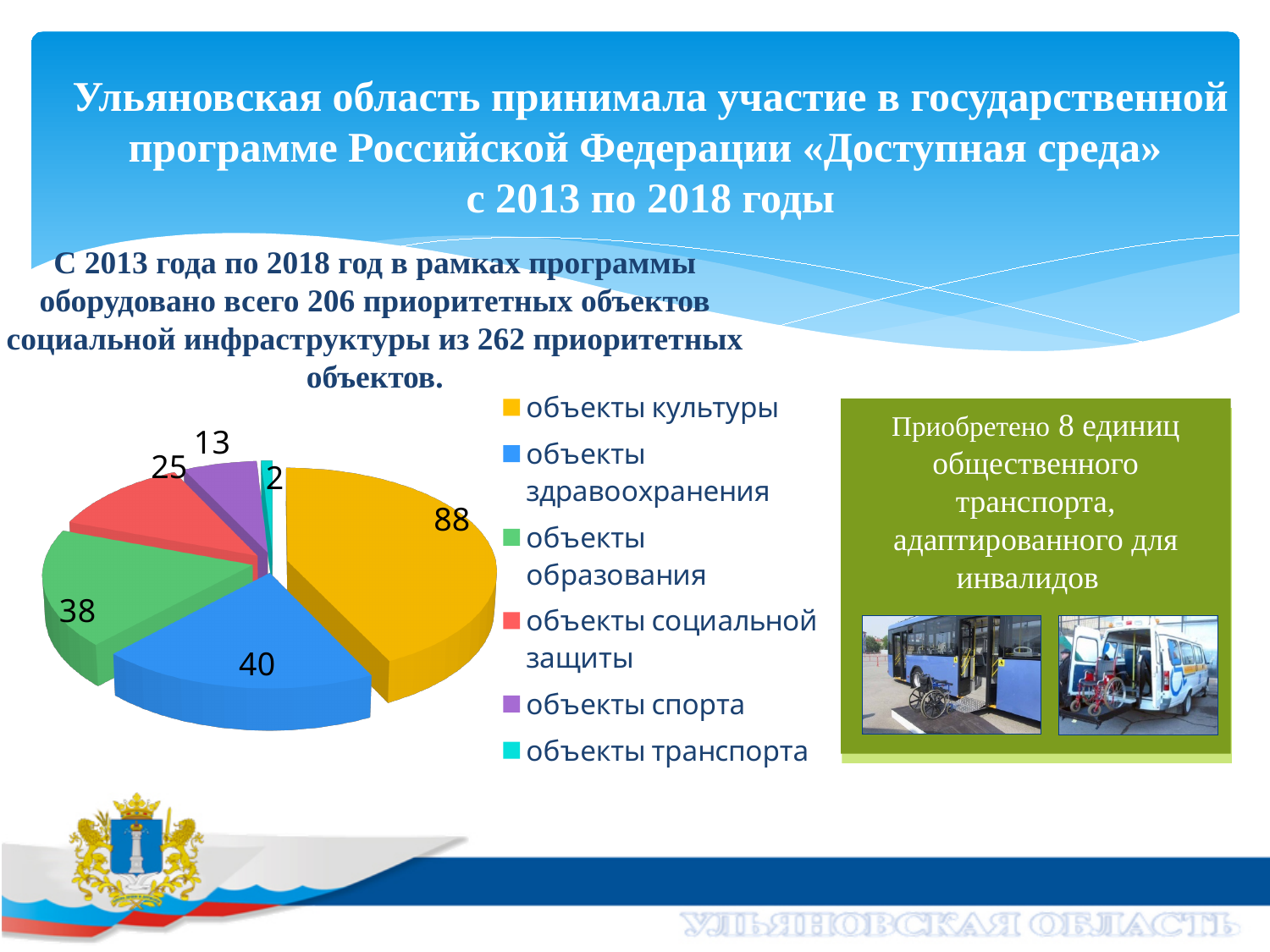
What is the value for объекты здравоохранения in the pie chart? 40 What type of chart is shown on the slide? pie chart What is the value for объекты образования in the pie chart? 38 What colour is the slice for объекты образования? green Which category has the smallest slice in the pie chart? объекты транспорта Which category has the largest slice in the pie chart? объекты культуры Which is larger: объекты социальной защиты or объекты спорта? объекты социальной защиты How many slices does the pie chart have? 6 What is the value for объекты социальной защиты in the pie chart? 25 What is the difference between the values for объекты культуры and объекты здравоохранения? 48 What is the value for объекты культуры in the pie chart? 88 What is the value for объекты транспорта in the pie chart? 2